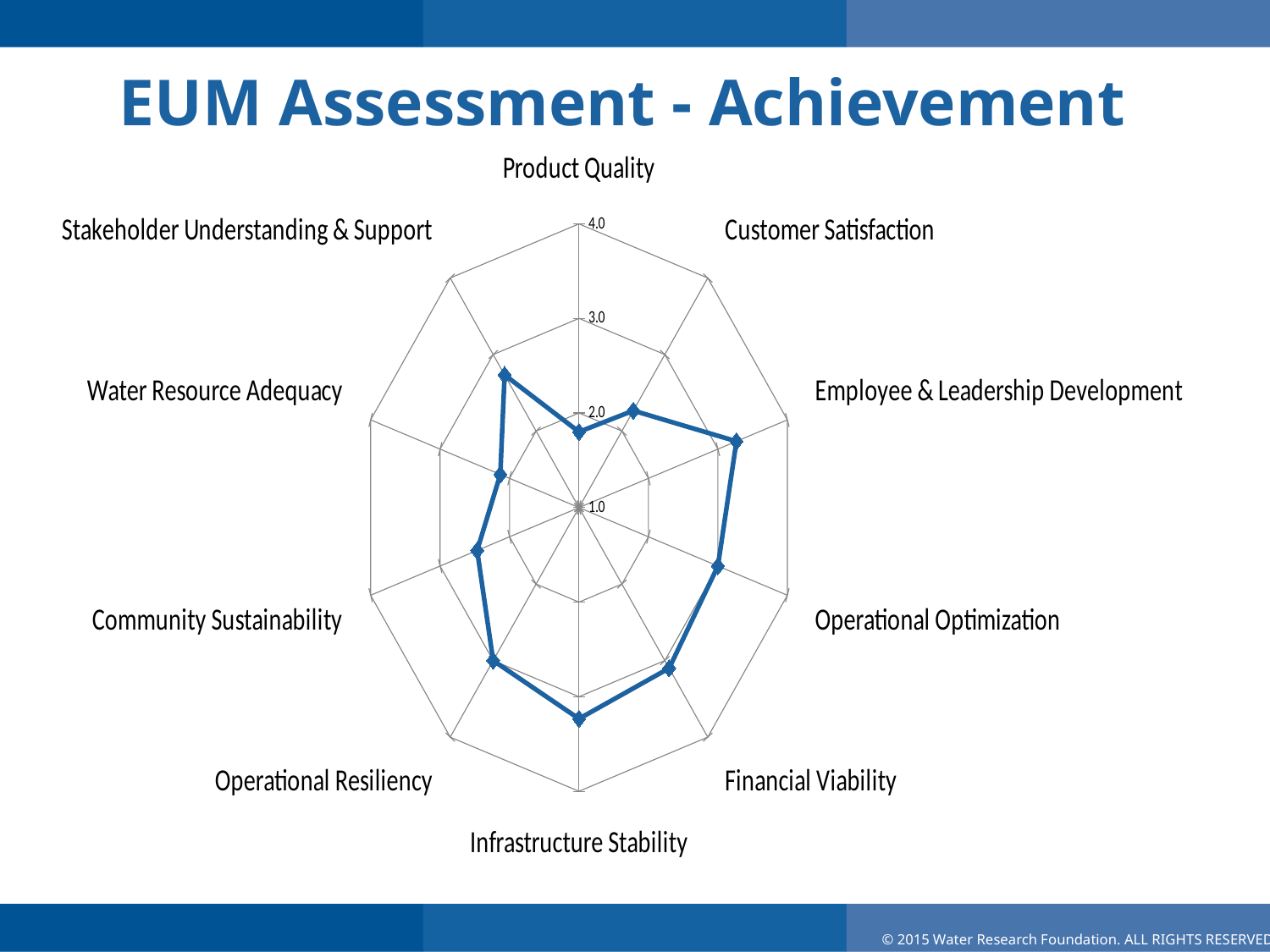
Is the value for Stakeholder Understanding & Support greater or less than 3.0? less What kind of chart is shown on the slide? radar chart Is the value for Operational Optimization greater or less than 2.0? greater Which has the larger value, Infrastructure Stability or Product Quality? Infrastructure Stability Which has the larger value, Employee & Leadership Development or Customer Satisfaction? Employee & Leadership Development Is the value for Infrastructure Stability greater or less than 3.0? greater What is the title of the slide's chart? EUM Assessment - Achievement How many categories (axes) does the radar chart have? 10 What is the highest tick value shown on the radar chart's scale? 4.0 Which category has the lowest value on the radar chart? Product Quality